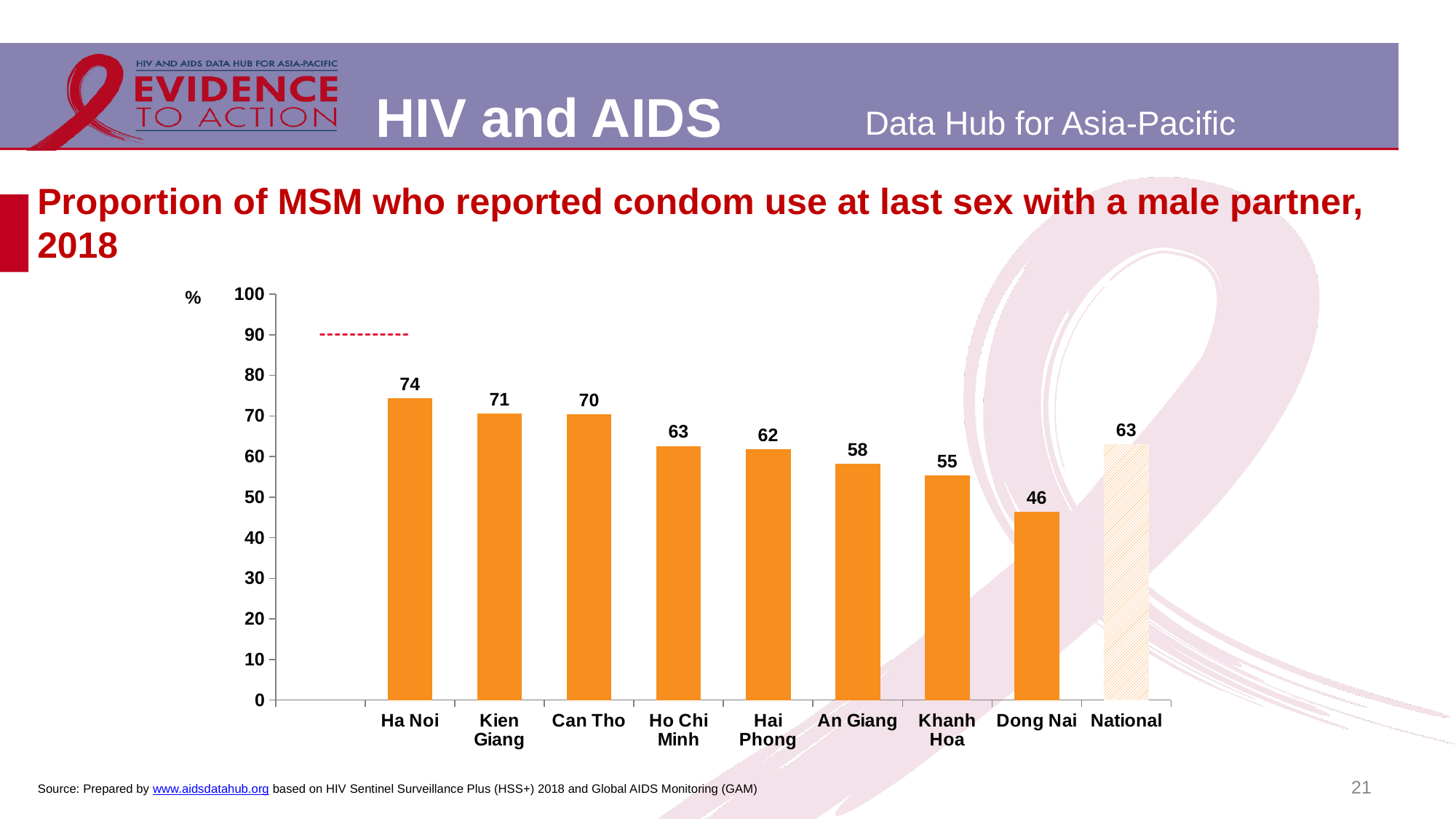
What is the value for Khanh Hoa? 55 Do the values rise or fall from Ha Noi to Dong Nai along the x axis? Fall How many categories are shown on the x axis? 9 What is the value for Dong Nai? 46 What is the value for Ha Noi? 74 Which category has the highest value? Ha Noi Which is larger, the value for Kien Giang or the value for Hai Phong? Kien Giang What kind of chart is shown on the slide? Bar chart What is the difference between the values for Ha Noi and Dong Nai? 28 What is the National value? 63 Which category has the lowest value? Dong Nai What is the difference between the Ho Chi Minh value and the An Giang value? 5